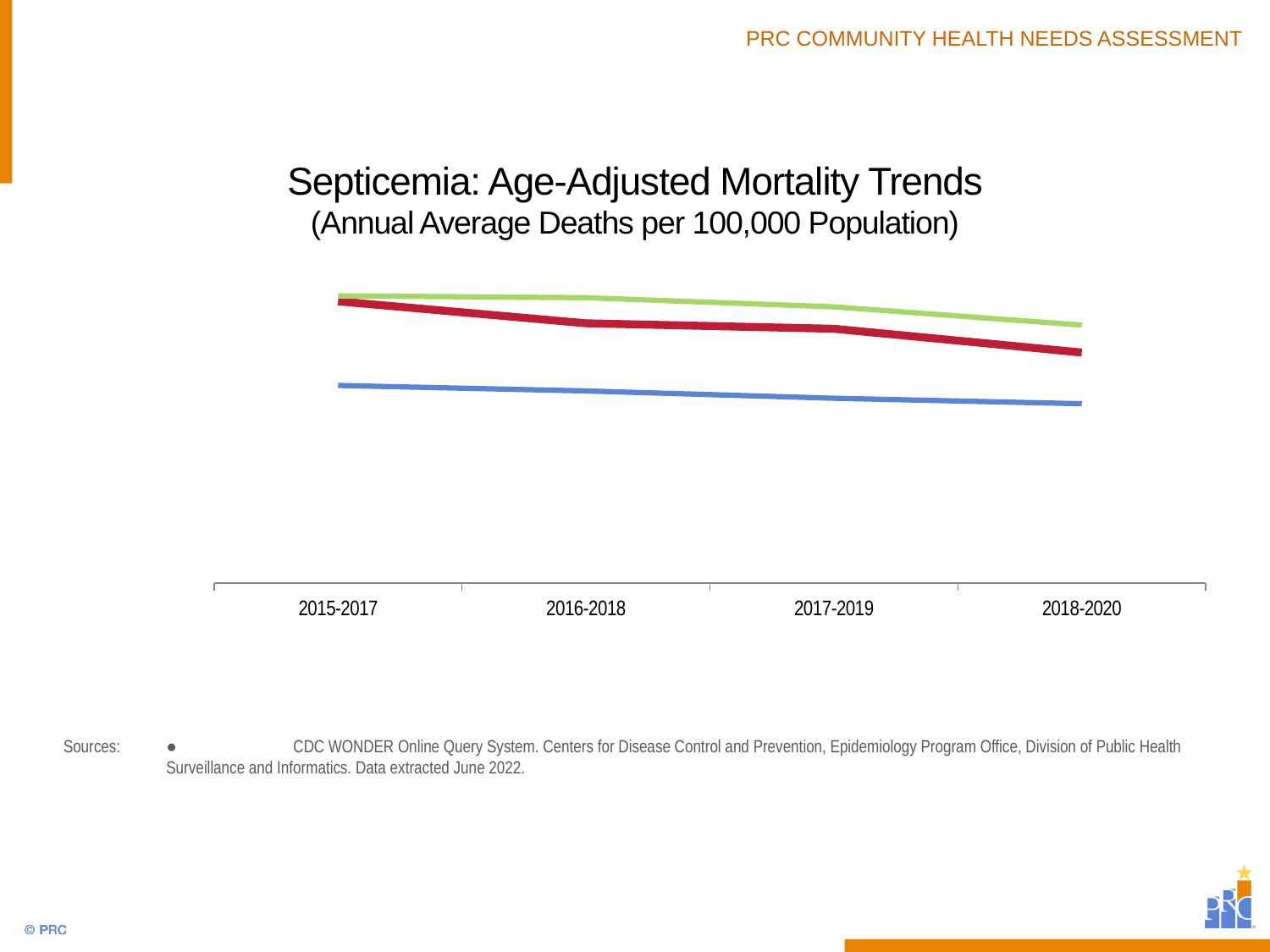
Does the red line rise or fall from 2015-2017 to 2018-2020? Fall What unit does the chart subtitle say the values are measured in? Annual Average Deaths per 100,000 Population Which coloured line is the highest across all periods? Green What is the first time period shown on the x axis? 2015-2017 What is the last time period shown on the x axis? 2018-2020 What type of chart is shown on the slide? Line chart Does the green line rise or fall from 2015-2017 to 2018-2020? Fall Does the blue line rise or fall from 2015-2017 to 2018-2020? Fall Which coloured line is the lowest across all periods? Blue What is the title of the chart? Septicemia: Age-Adjusted Mortality Trends How many time periods are shown on the x axis? 4 How many lines are plotted on the chart? 3